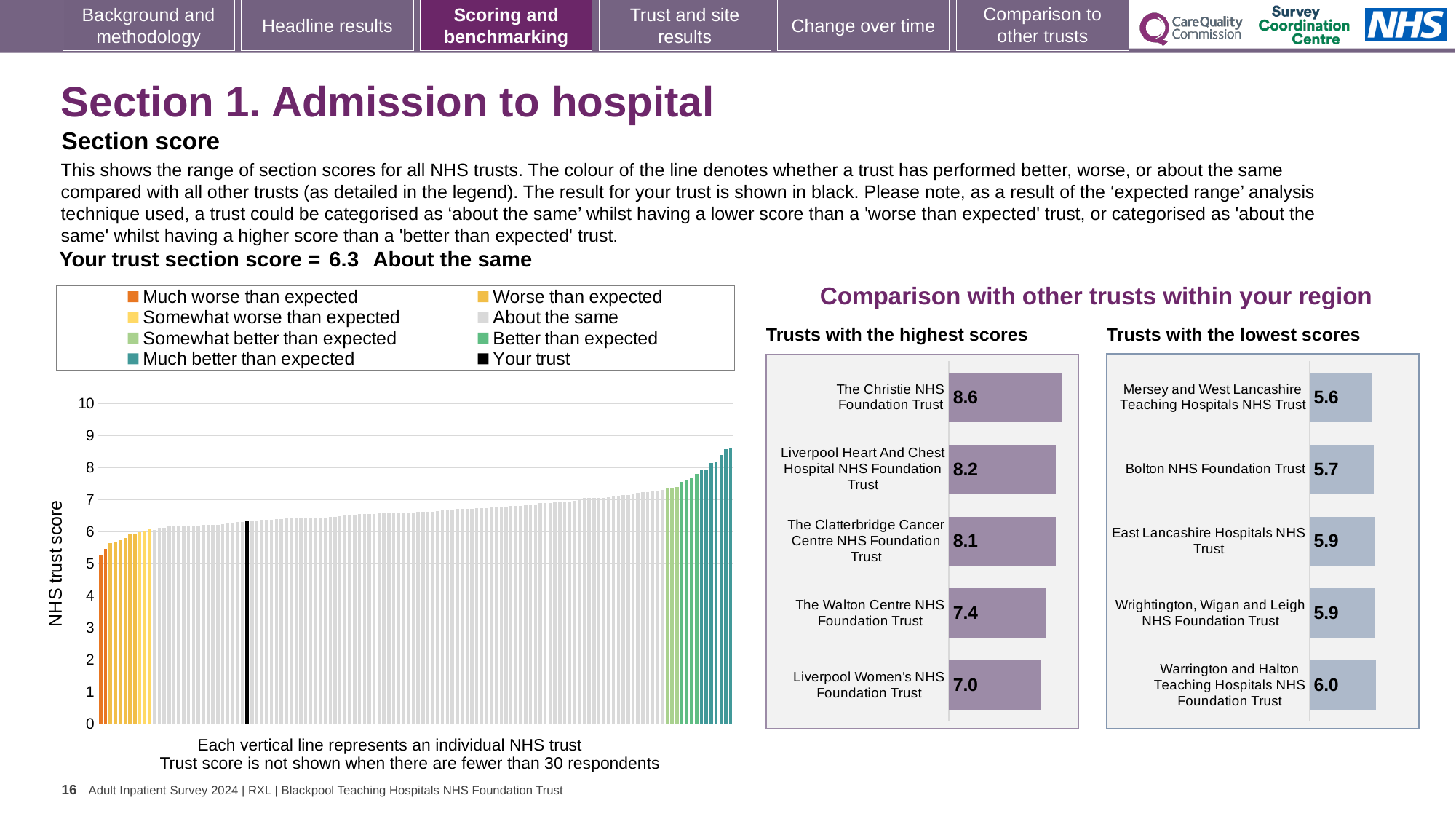
In the 'Trusts with the highest scores' chart, which trust has the highest score? The Christie NHS Foundation Trust In the 'Trusts with the highest scores' chart, what is the difference between the scores of The Christie NHS Foundation Trust and Liverpool Women's NHS Foundation Trust? 1.6 In the main NHS trust score chart on the left, do the trust scores rise or fall from left to right? Rise In the 'Trusts with the lowest scores' chart, which has the larger score: Bolton NHS Foundation Trust or Warrington and Halton Teaching Hospitals NHS Foundation Trust? Warrington and Halton Teaching Hospitals NHS Foundation Trust How many entries does the legend of the main NHS trust score chart on the left list? 8 What kind of chart is the 'Trusts with the highest scores' chart? Bar chart In the 'Trusts with the highest scores' chart, what is the score for The Christie NHS Foundation Trust? 8.6 In the 'Trusts with the lowest scores' chart, which trust has the lowest score? Mersey and West Lancashire Teaching Hospitals NHS Trust In the 'Trusts with the lowest scores' chart, what is the score for Bolton NHS Foundation Trust? 5.7 In the main NHS trust score chart on the left, what is the section score for your trust? 6.3 In the 'Trusts with the highest scores' chart, what is the score for The Walton Centre NHS Foundation Trust? 7.4 How many trusts are shown in the 'Trusts with the lowest scores' chart? 5